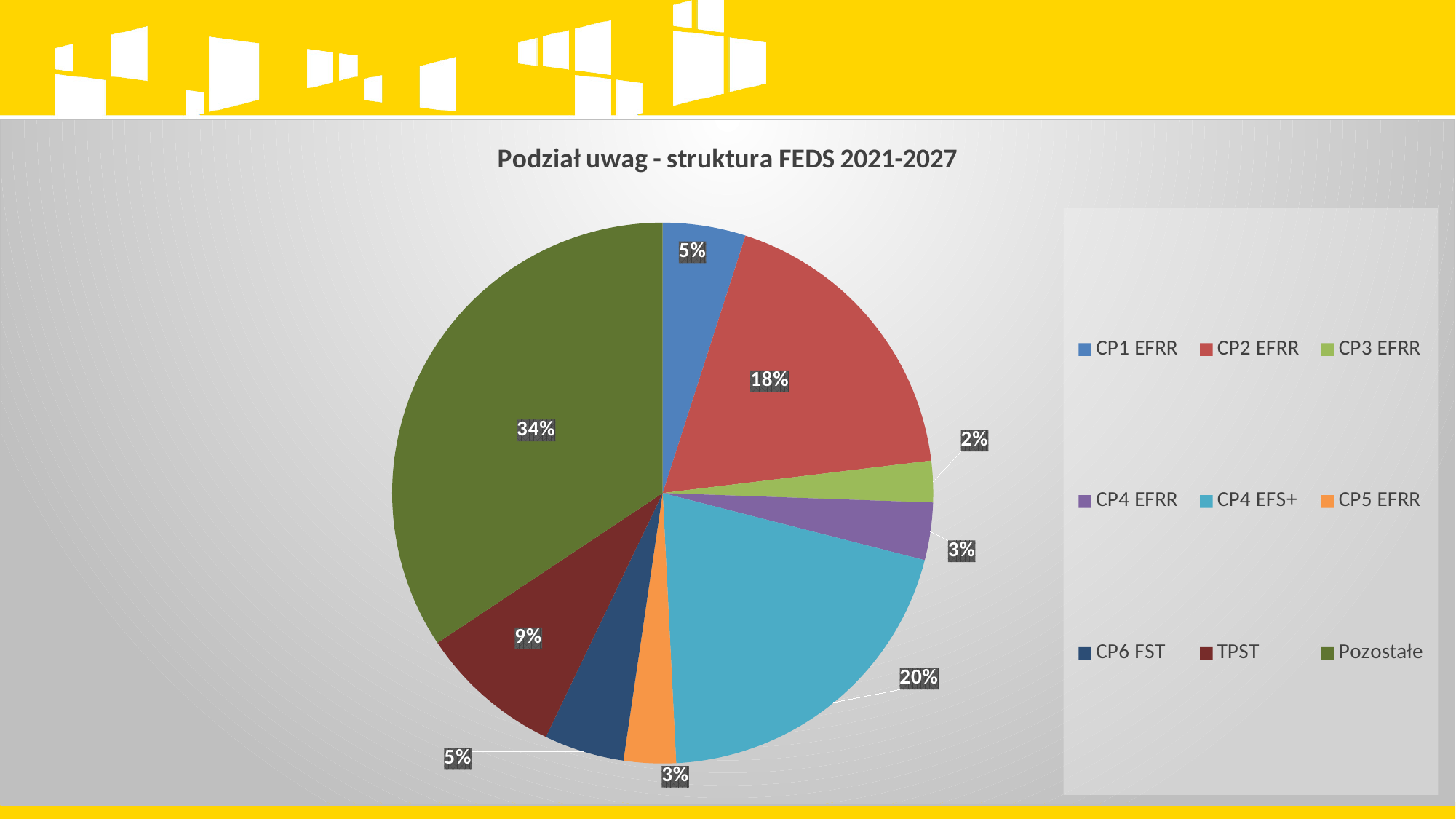
How many categories does the legend list? 9 What kind of chart is shown on the slide? pie chart What is the value for CP2 EFRR? 18% What is the title of the chart? Podział uwag - struktura FEDS 2021-2027 What share of the pie does Pozostałe have? 34% Which category has the largest share of the pie? Pozostałe What is the value for CP4 EFS+? 20% What is the difference between the shares of CP4 EFS+ and CP2 EFRR? 2% What is the value for TPST? 9% What is the combined share of CP1 EFRR and CP6 FST? 10% Which is larger, the share for TPST or the share for CP6 FST? TPST Which category has the smallest share of the pie? CP3 EFRR